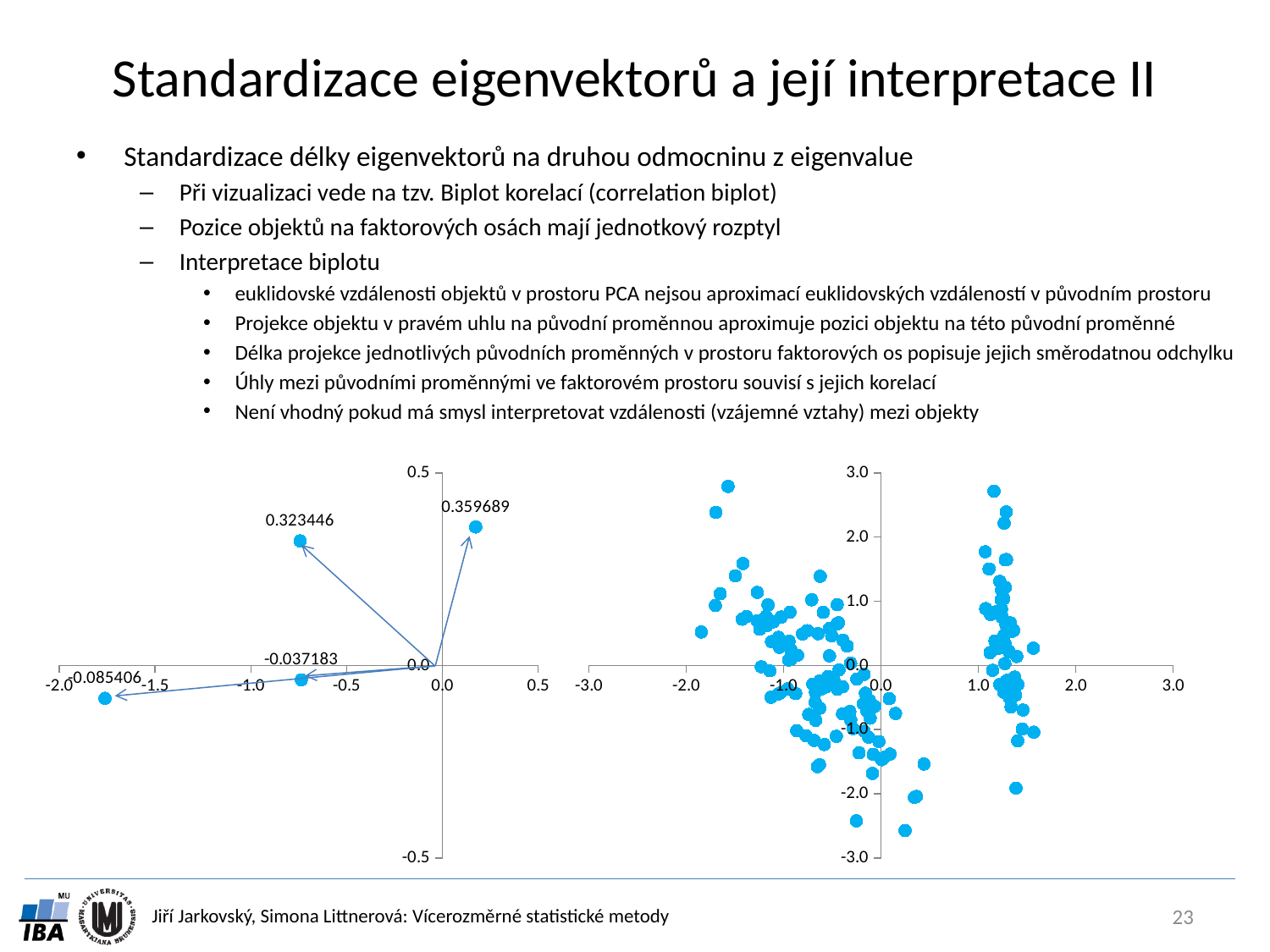
In the left chart, what is the highest data label value shown? 0.359689 What kind of chart is the chart on the right of the slide? scatter chart What is the maximum value shown on the y axis of the left chart? 0.5 In the left chart, what is the lowest data label value shown? -0.085406 In the left chart, is the y-axis position of the point labelled 0.359689 greater or less than 0.0? greater What kind of chart is the chart on the left of the slide? scatter chart In the left chart, is the x-axis position of the point labelled -0.085406 greater or less than -1.5? less What is the maximum value shown on the x axis of the right chart? 3.0 In the left chart, what is the difference between the data labels 0.359689 and 0.323446? 0.036243 In the left chart, how many data labels are negative? 2 In the left chart, how many data points are plotted? 4 In the left chart, which is larger: the data label 0.323446 or the data label -0.037183? 0.323446